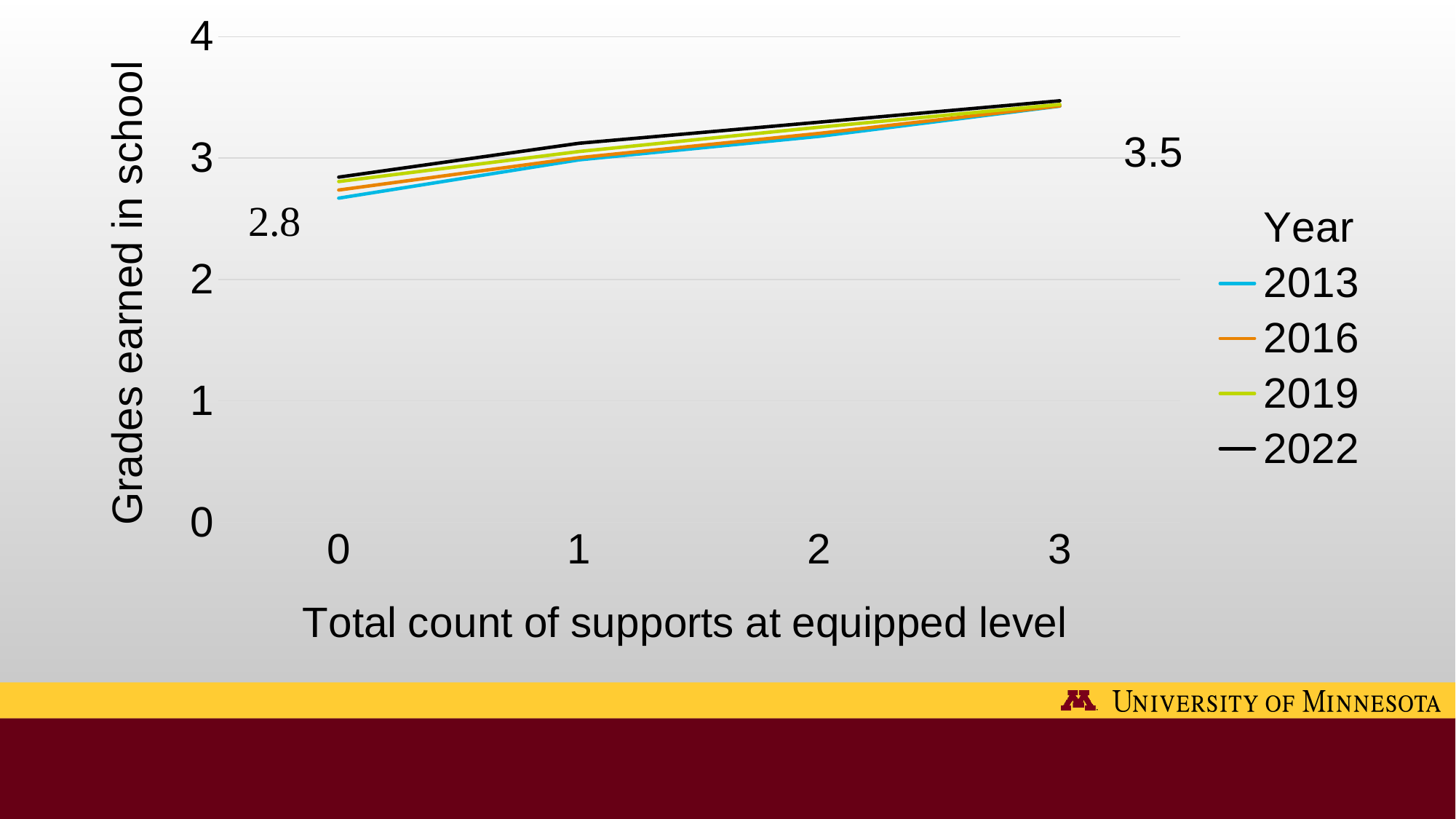
How many series does the legend list? 4 How many points are there along the x axis (Total count of supports at equipped level)? 4 What is the title of the y axis? Grades earned in school At 0 supports, which year has the highest value? 2022 Do the grades earned in school rise or fall as the total count of supports increases? rise What is the title of the legend? Year Is the value for 2013 at 3 supports greater or less than 3? greater At 0 supports, which year has the lowest value? 2013 At 0 supports, which year has the higher value: 2013 or 2022? 2022 Is the value for 2013 at 0 supports greater or less than 3? less Is the value for 2022 at 0 supports greater or less than 2? greater What kind of chart is shown on the slide? line chart